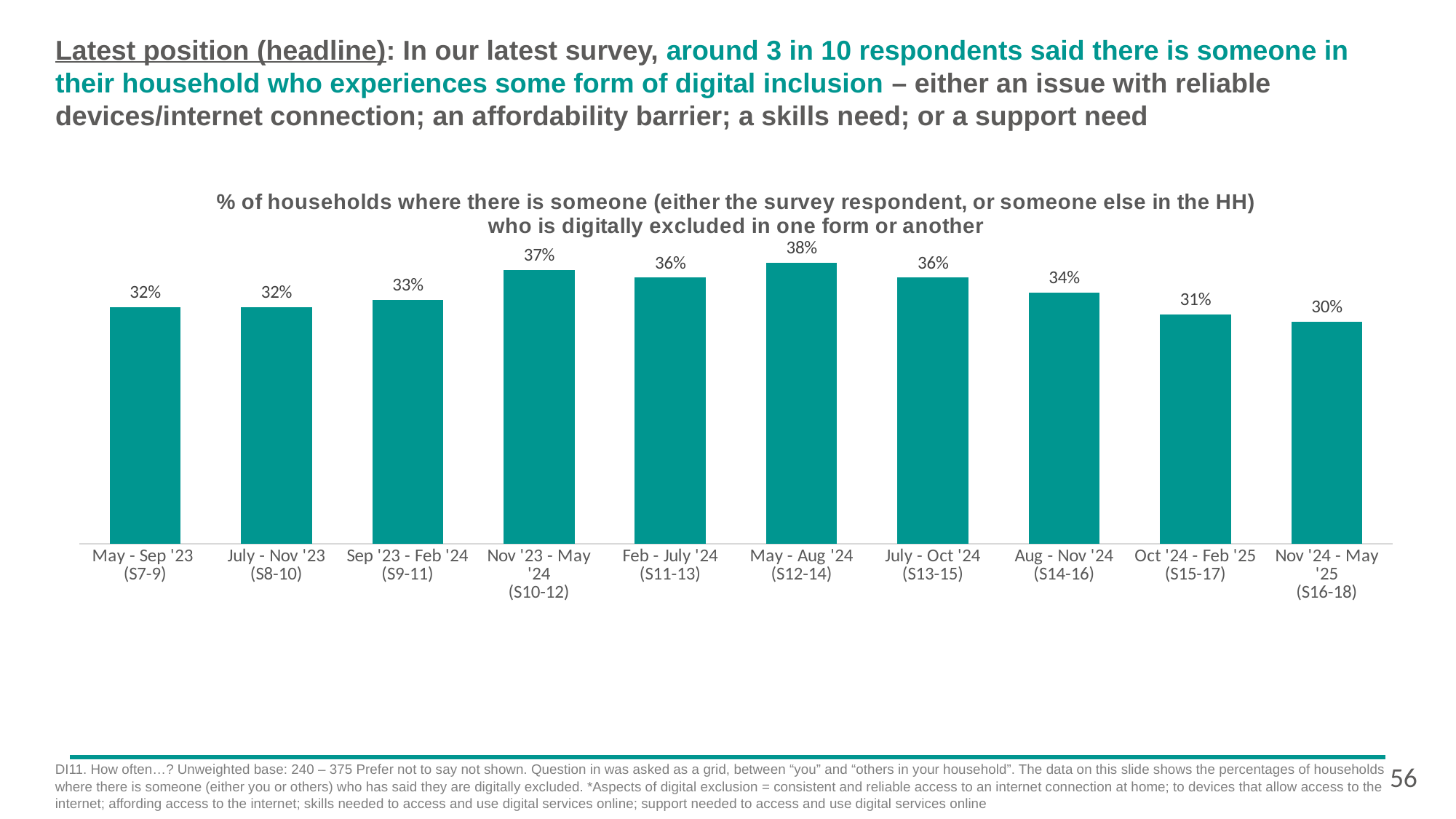
Which period has the highest value? May - Aug '24 (S12-14) Do the values rise or fall from May - Aug '24 (S12-14) to Nov '24 - May '25 (S16-18)? Fall What is the value for May - Aug '24 (S12-14)? 38% Which is larger, the value for Nov '23 - May '24 (S10-12) or the value for Aug - Nov '24 (S14-16)? Nov '23 - May '24 (S10-12) What kind of chart is shown on the slide? Bar chart What is the value for Nov '24 - May '25 (S16-18)? 30% What is the value for Sep '23 - Feb '24 (S9-11)? 33% Which period has the lowest value? Nov '24 - May '25 (S16-18) What is the difference between the values for Oct '24 - Feb '25 (S15-17) and Nov '24 - May '25 (S16-18)? 1 percentage point How many periods are shown on the x axis? 10 What colour are the bars in the chart? Teal What is the difference between the values for May - Aug '24 (S12-14) and Nov '24 - May '25 (S16-18)? 8 percentage points